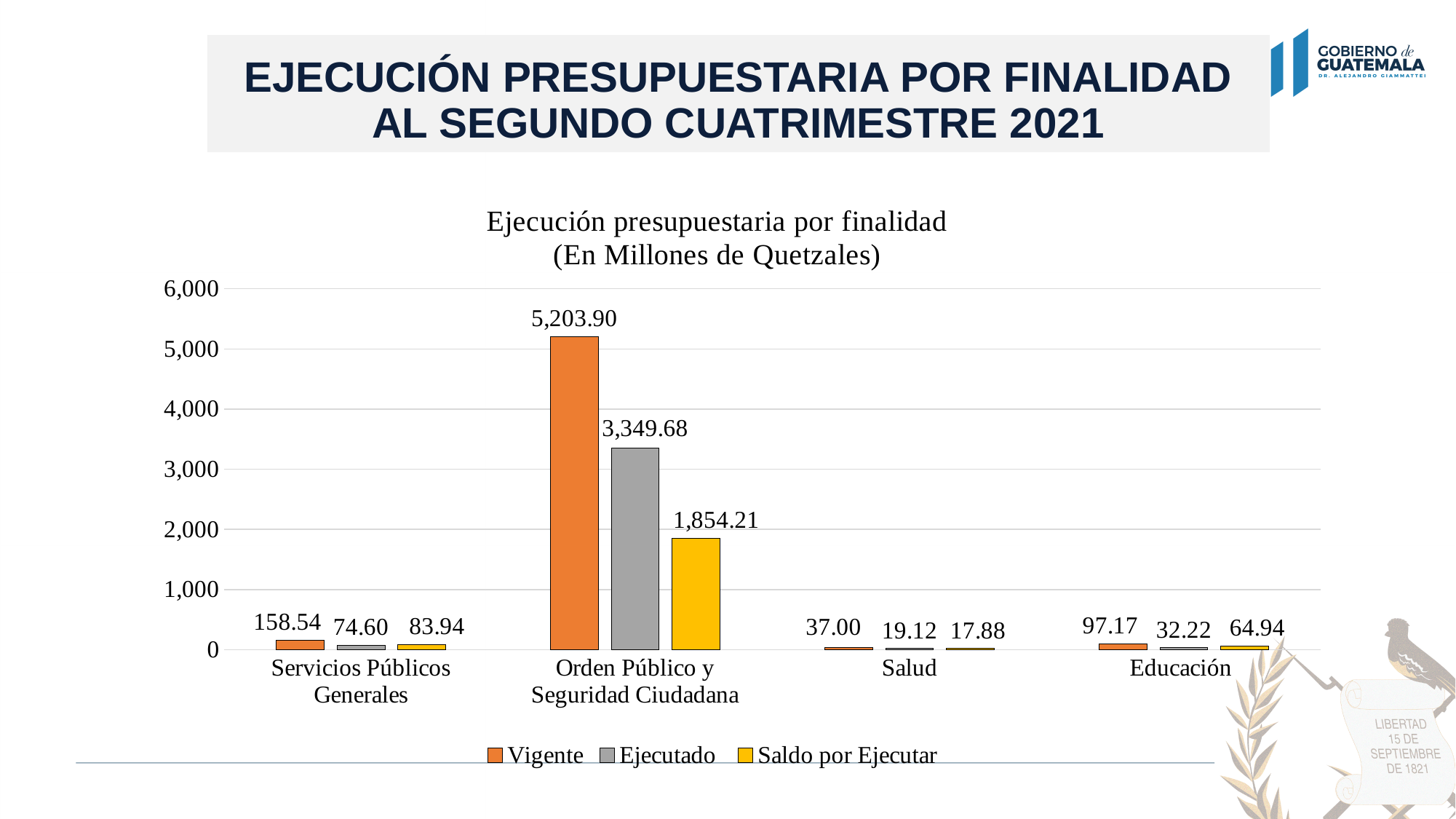
What is the Vigente value for Orden Público y Seguridad Ciudadana? 5,203.90 Is the Saldo por Ejecutar value for Orden Público y Seguridad Ciudadana greater or less than 2,000? less How many series does the legend list? 3 Which category has the lowest Vigente value? Salud What is the difference between the Vigente and Ejecutado values for Orden Público y Seguridad Ciudadana? 1,854.22 Which category has the highest Ejecutado value? Orden Público y Seguridad Ciudadana What kind of chart is shown on the slide? Bar chart What is the Ejecutado value for Salud? 19.12 What is the Saldo por Ejecutar value for Educación? 64.94 What is the Vigente value for Servicios Públicos Generales? 158.54 Which is larger for Educación: Ejecutado or Saldo por Ejecutar? Saldo por Ejecutar How many categories are shown on the x axis? 4